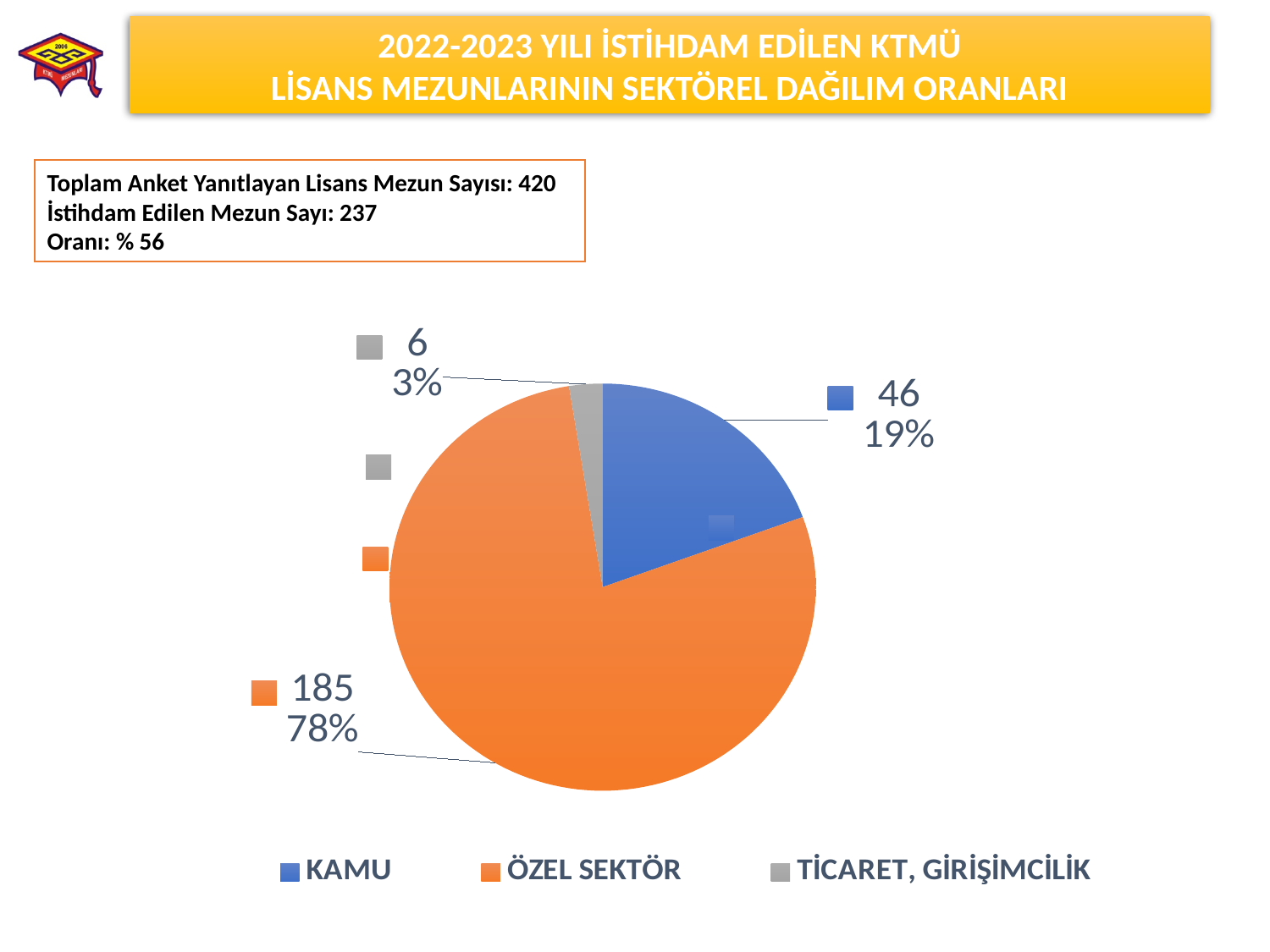
Which category has the smallest slice? TİCARET, GİRİŞİMCİLİK What is the value for KAMU? 46 What share of the pie does TİCARET, GİRİŞİMCİLİK represent? 3% What share of the pie does KAMU represent? 19% How many slices does the pie chart have? 3 What kind of chart is shown on the slide? pie chart Which category has the largest slice? ÖZEL SEKTÖR What is the difference between the values for ÖZEL SEKTÖR and KAMU? 139 Which colour represents KAMU in the pie chart? blue What is the value for TİCARET, GİRİŞİMCİLİK? 6 What is the value for ÖZEL SEKTÖR? 185 What share of the pie does ÖZEL SEKTÖR represent? 78%